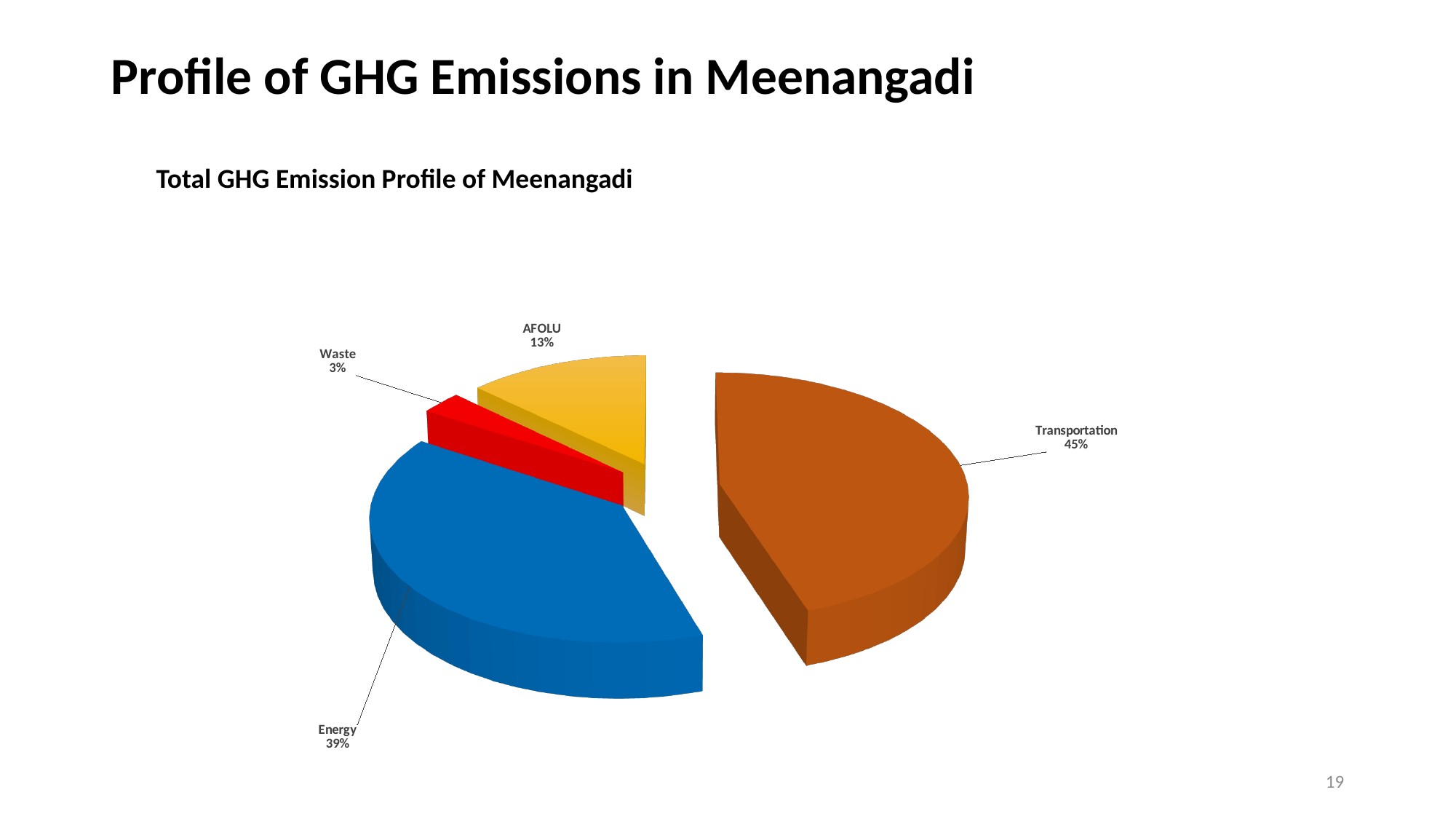
Which has a larger share, AFOLU or Waste? AFOLU What kind of chart is shown on the slide? Pie chart How many sectors are shown in the pie chart? 4 What is the difference in percentage points between the Transportation and Energy shares? 6 What share of total GHG emissions does AFOLU account for? 13% Which sector has the smallest share of GHG emissions? Waste What share of total GHG emissions does Waste account for? 3% What share of total GHG emissions does Transportation account for? 45% What is the title of the chart? Total GHG Emission Profile of Meenangadi What is the difference in percentage points between the AFOLU and Waste shares? 10 Which sector has the largest share of GHG emissions? Transportation